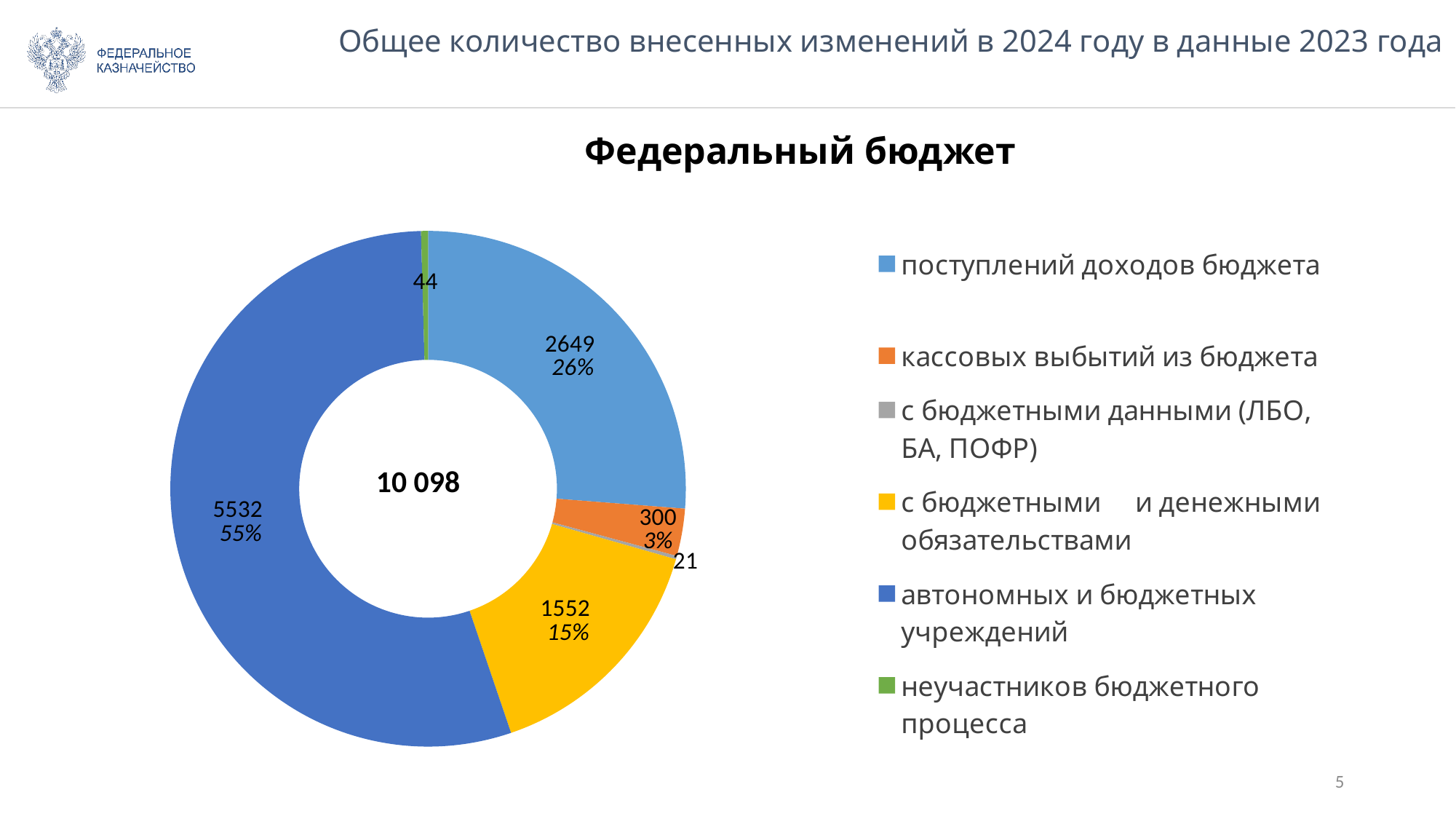
What is the value for "поступлений доходов бюджета"? 2649 What is the difference between the values for "автономных и бюджетных учреждений" and "поступлений доходов бюджета"? 2883 What type of chart is shown on the slide? Donut (pie) chart Which is larger: the value for "кассовых выбытий из бюджета" or for "неучастников бюджетного процесса"? кассовых выбытий из бюджета What total number is shown in the centre of the donut chart? 10 098 Which category has the smallest value? с бюджетными данными (ЛБО, БА, ПОФР) What share of the chart does "с бюджетными и денежными обязательствами" represent? 15% How many categories does the legend list? 6 What is the value for "с бюджетными данными (ЛБО, БА, ПОФР)"? 21 Which category has the largest share of the chart? автономных и бюджетных учреждений What is the value for "неучастников бюджетного процесса"? 44 What is the value for "автономных и бюджетных учреждений"? 5532